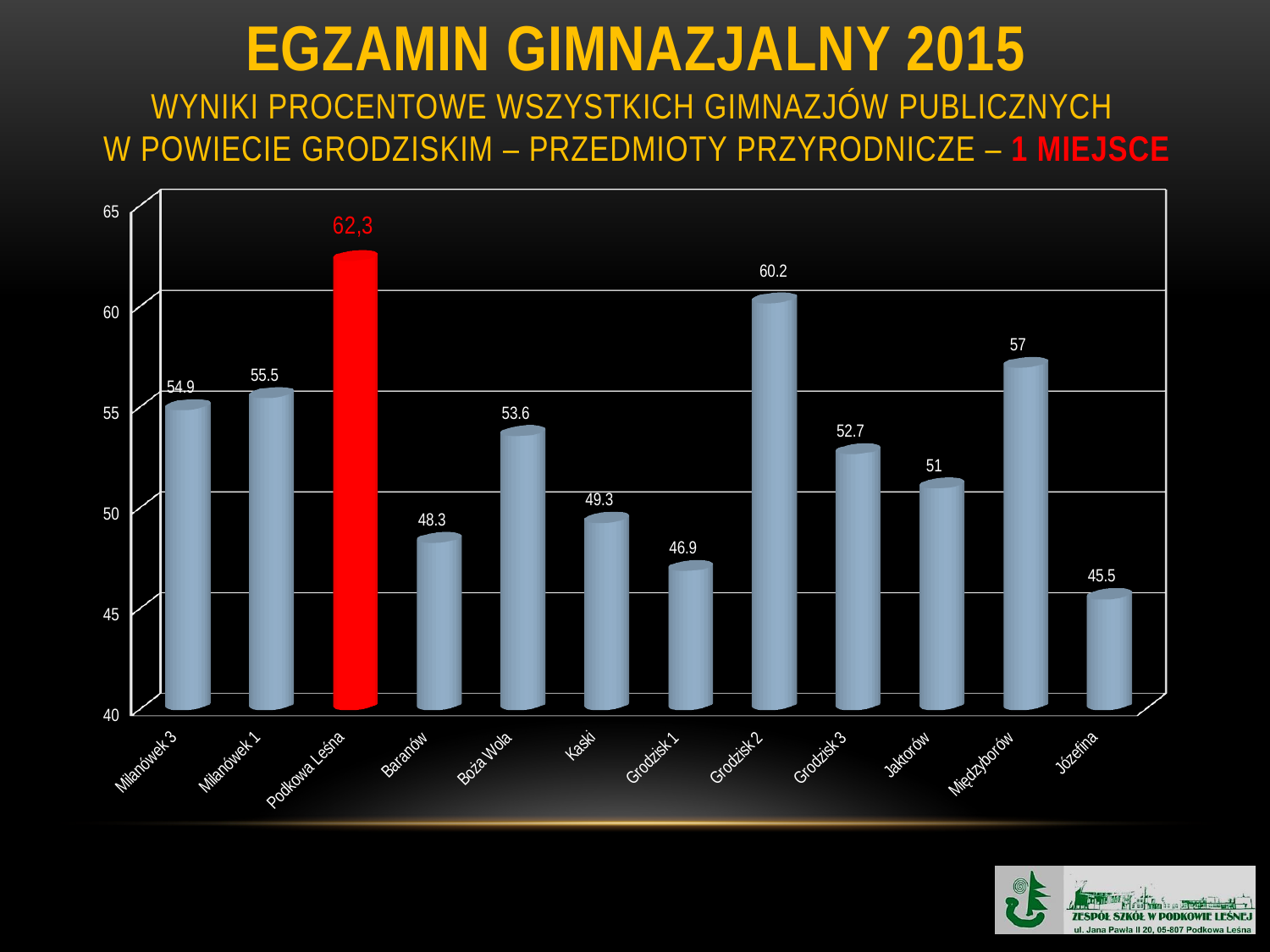
What is the value for Grodzisk 2? 60.2 What is the value for Podkowa Leśna? 62,3 What is the difference between the values for Międzyborów and Jaktorów? 6 What kind of chart is shown on the slide? bar chart What is the difference between the values for Grodzisk 2 and Grodzisk 1? 13.3 How many categories are shown on the x axis? 12 Which is larger, the value for Milanówek 1 or the value for Boża Wola? Milanówek 1 Which category has the highest value? Podkowa Leśna Which category has the lowest value? Józefina Which bar is coloured red? Podkowa Leśna What is the value for Jaktorów? 51 What is the value for Józefina? 45.5